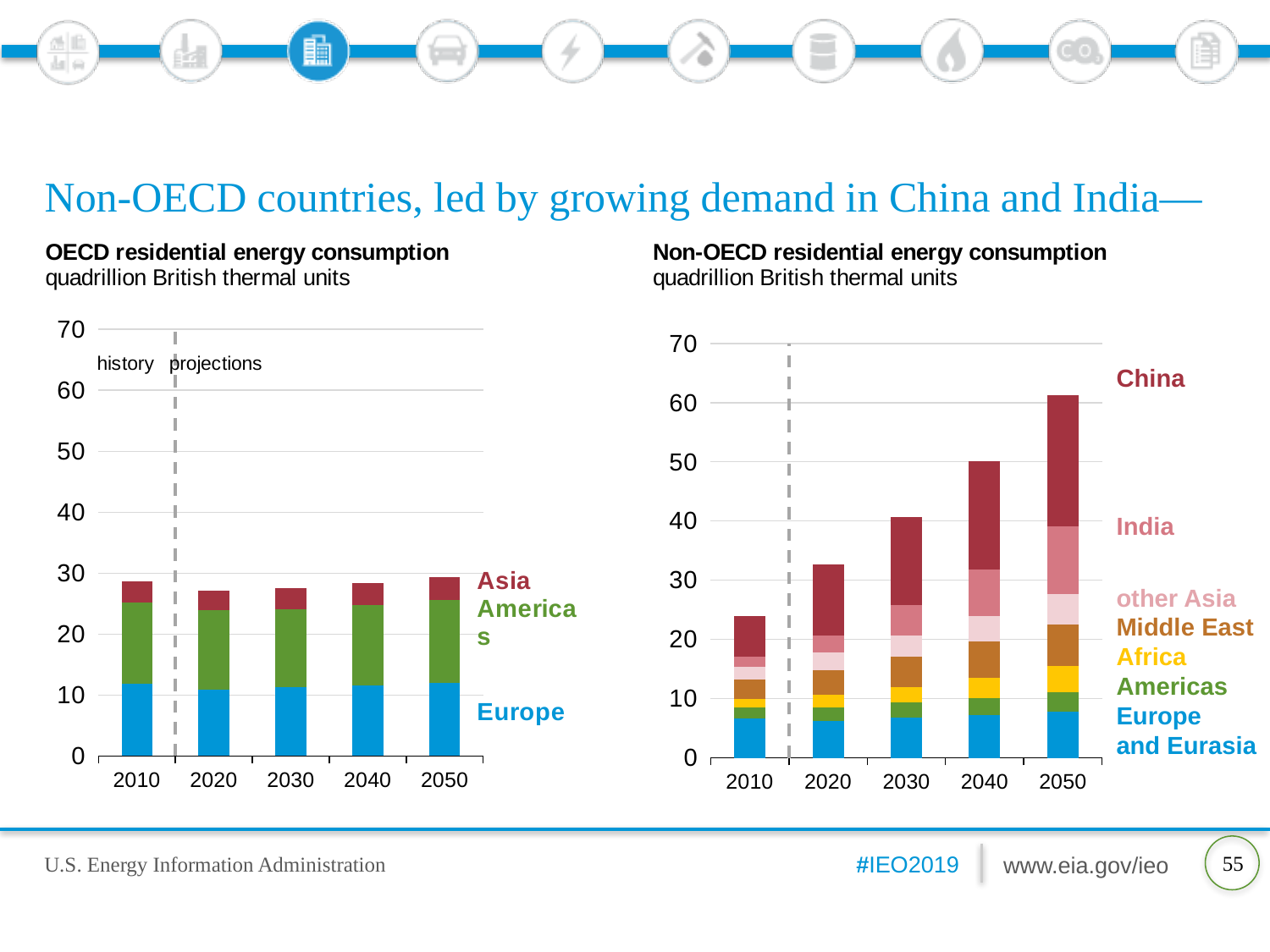
In the OECD residential energy consumption chart, is the total value for 2010 greater or less than 30? less In the Non-OECD residential energy consumption chart, do total values rise or fall from 2010 to 2050? rise In the Non-OECD residential energy consumption chart, is the total value for 2040 greater or less than 40? greater In the Non-OECD residential energy consumption chart, which is larger: the total for 2040 or the total for 2020? 2040 How many series does the OECD residential energy consumption chart show? 3 How many series does the Non-OECD residential energy consumption chart show? 7 How many years are shown on the x axis of the Non-OECD residential energy consumption chart? 5 Which is larger in 2050: total OECD residential energy consumption or total Non-OECD residential energy consumption? Non-OECD In the Non-OECD residential energy consumption chart, which year has the highest total consumption? 2050 What unit is used on the y axis of both charts? quadrillion British thermal units What kind of chart is the OECD residential energy consumption chart? stacked bar chart In the Non-OECD residential energy consumption chart, which year has the lowest total consumption? 2010